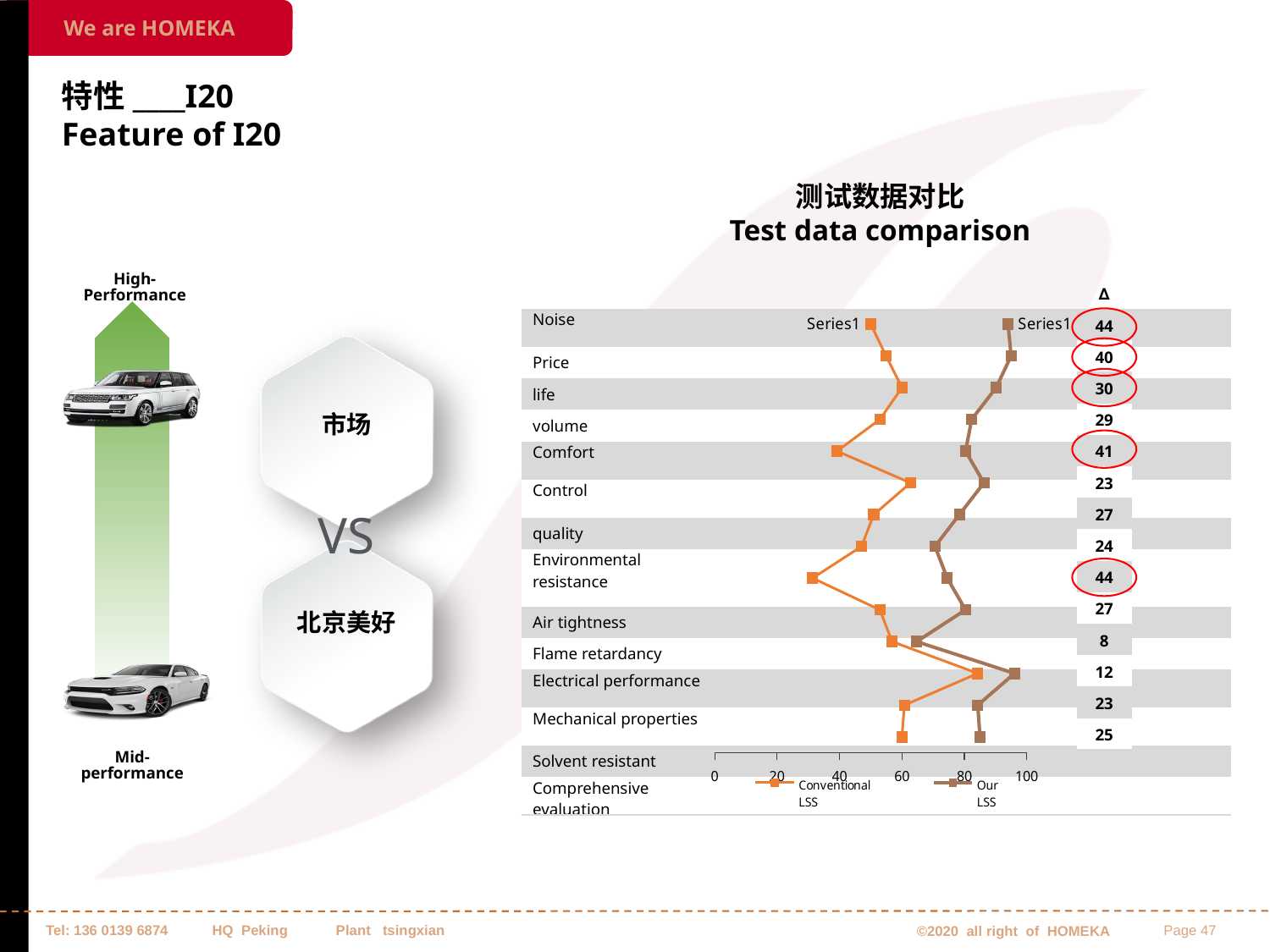
In the 'Test data comparison' chart, which category has the lowest Our LSS value? Flame retardancy In the 'Test data comparison' chart, is the Our LSS value for Noise greater or less than 80? greater In the 'Test data comparison' chart, is the Conventional LSS value for Comfort greater or less than 60? less What kind of chart is shown under the title 'Test data comparison'? line chart How many series does the legend of the 'Test data comparison' chart list? 2 In the 'Test data comparison' chart, which series has the higher value for Comfort, Conventional LSS or Our LSS? Our LSS In the 'Test data comparison' chart, is the Our LSS value for Electrical performance greater or less than 80? greater What are the two series named in the legend of the 'Test data comparison' chart? Conventional LSS and Our LSS What is the highest value shown on the x axis of the 'Test data comparison' chart? 100 In the 'Test data comparison' chart, which category has the highest Conventional LSS value? Electrical performance